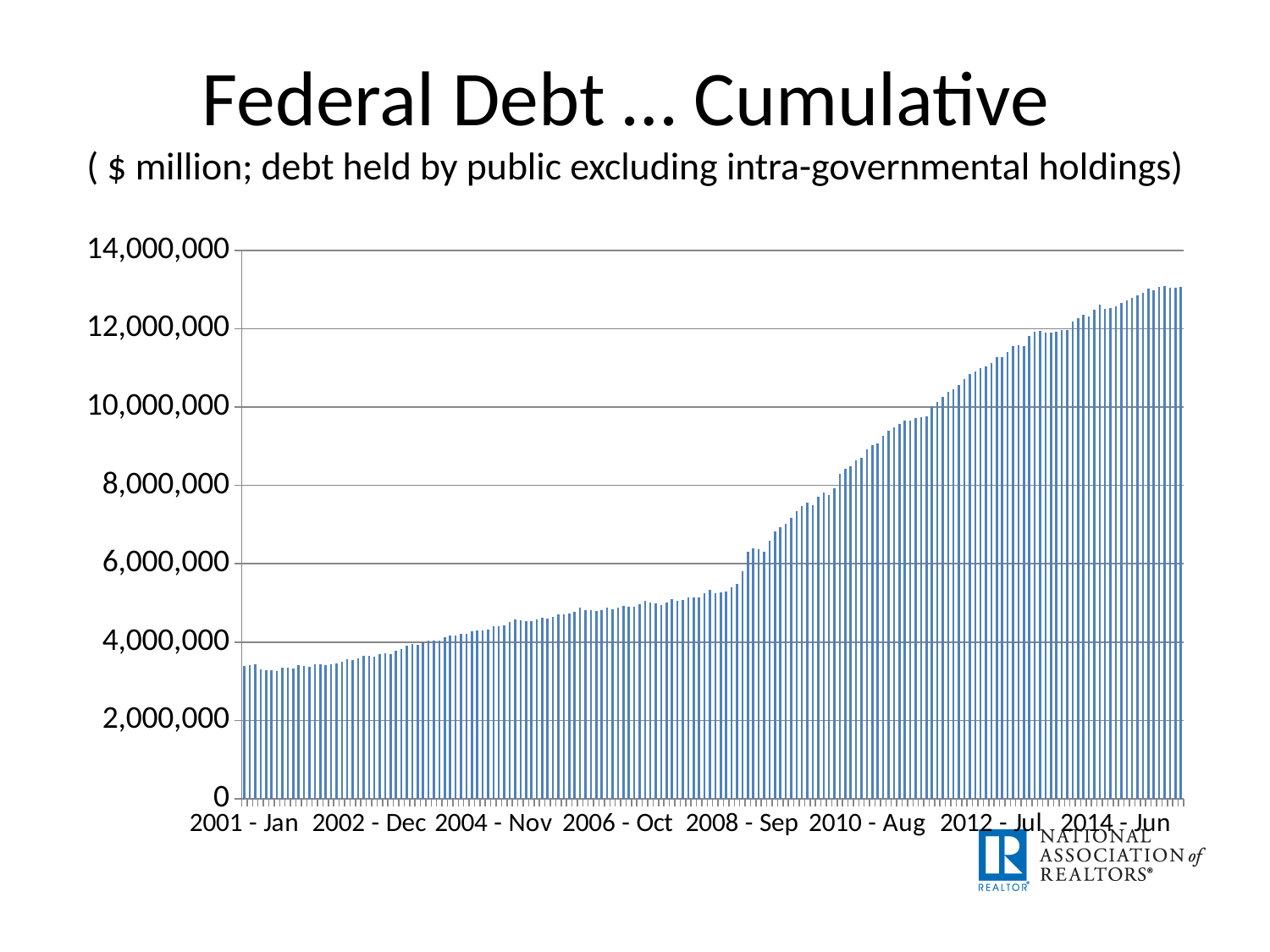
What kind of chart is shown on the slide? bar chart Is the value for 2010 - Aug greater or less than 6,000,000? greater Is the value for 2002 - Dec greater or less than 4,000,000? less Is the value for 2006 - Oct greater or less than 6,000,000? less Do the values generally rise or fall from 2001 - Jan to 2014 - Jun? rise What is the title of the chart? Federal Debt … Cumulative Which is larger, the value for 2001 - Jan or the value for 2014 - Jun? 2014 - Jun What is the highest value shown on the vertical axis? 14,000,000